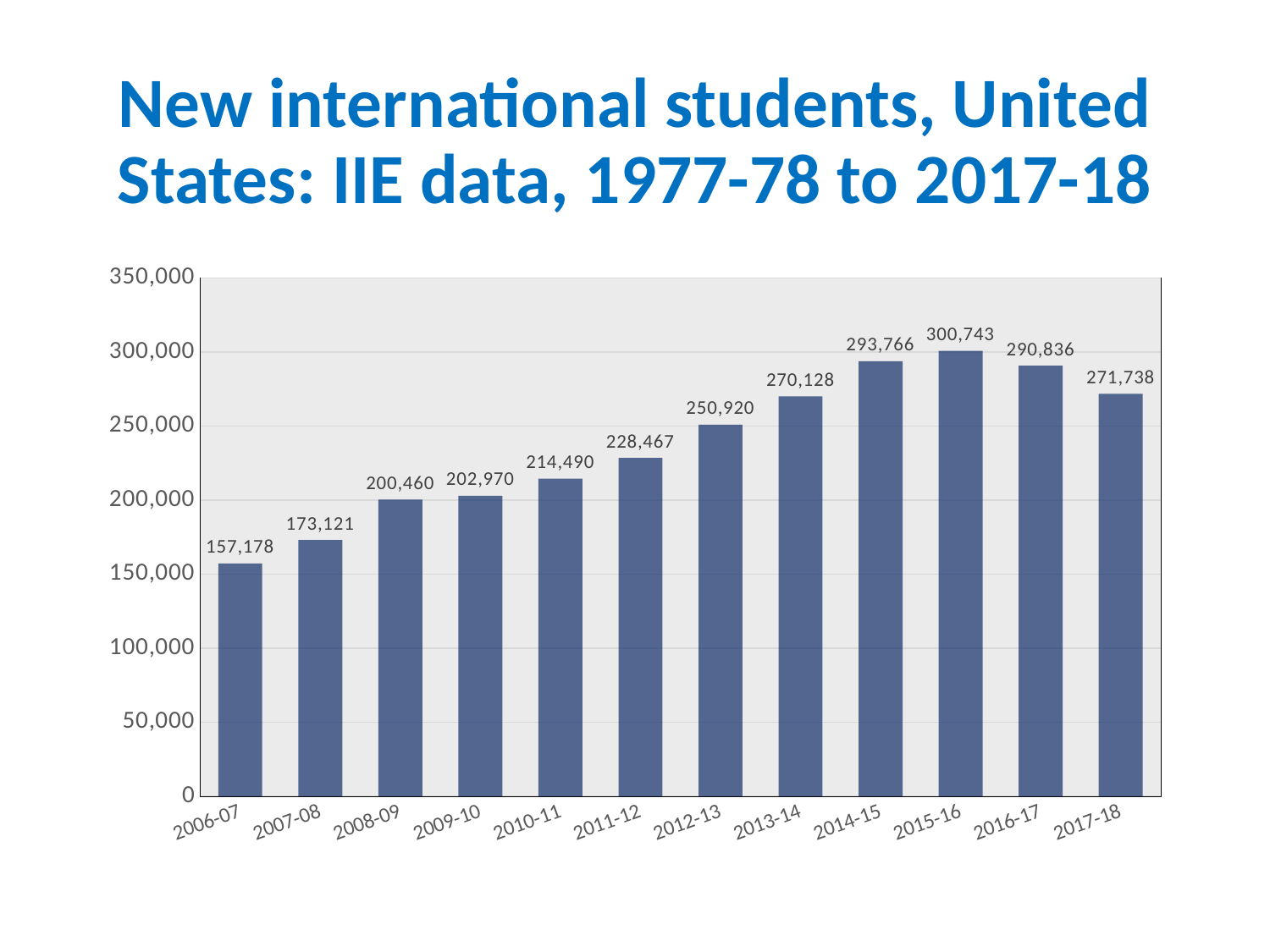
Is the value for 2013-14 greater or less than 250,000? greater What is the value for 2012-13? 250,920 What is the value for 2006-07? 157,178 Do the values rise or fall from 2006-07 to 2015-16? rise What is the difference between the values for 2015-16 and 2006-07? 143,565 What is the difference between the values for 2016-17 and 2017-18? 19,098 How many years are shown on the x axis? 12 Which year has the lowest value? 2006-07 What is the value for 2017-18? 271,738 Which year has the highest value? 2015-16 What kind of chart is shown on the slide? bar chart Which is larger, the value for 2014-15 or the value for 2016-17? 2014-15